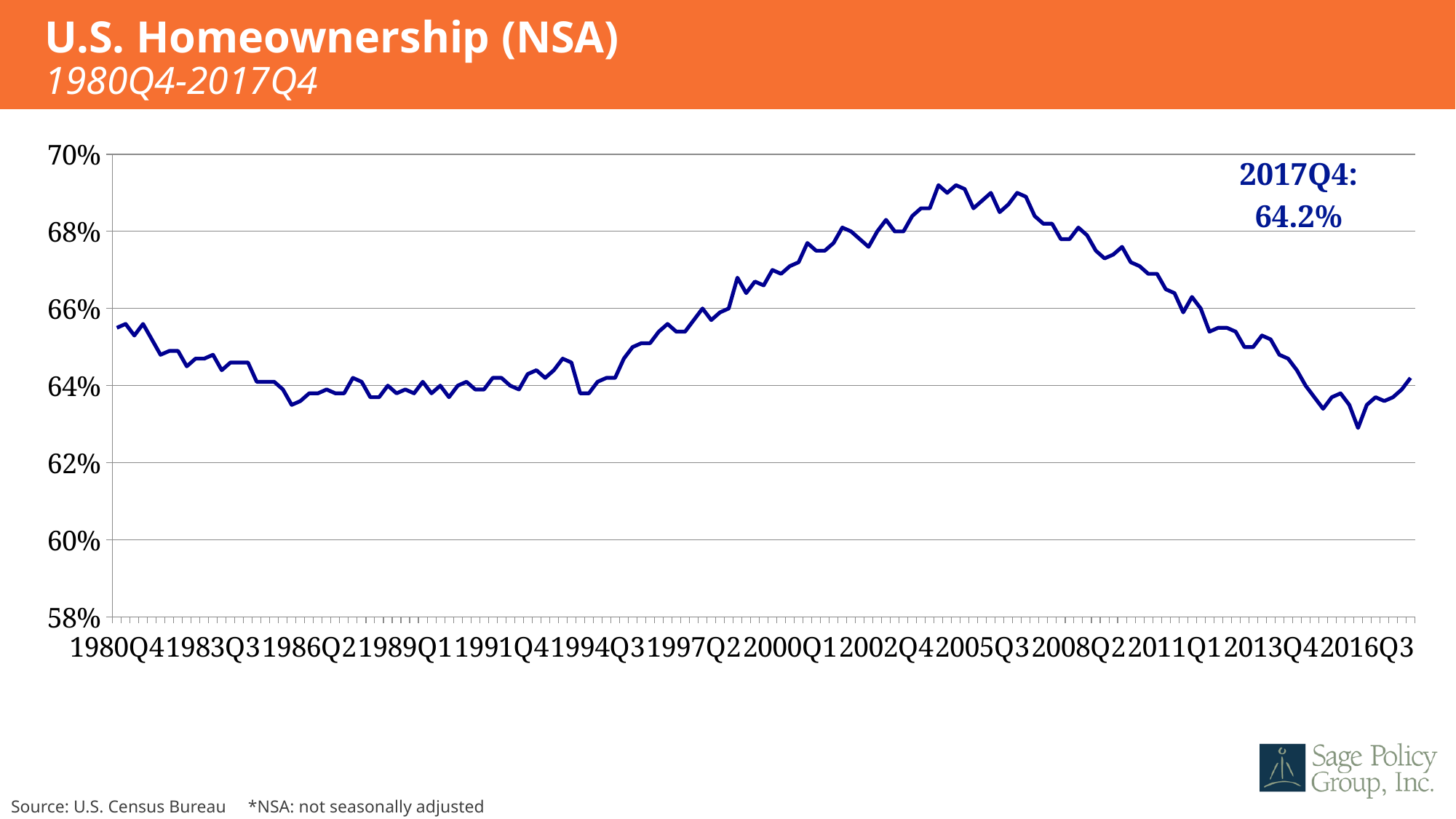
Does the homeownership rate rise or fall between 1994Q3 and 2005Q3? rise Is the lowest point on the line, around 2016, greater or less than 64%? less Does the homeownership rate rise or fall between 2005Q3 and 2016Q3? fall What is the title of the chart? U.S. Homeownership (NSA) Is the homeownership rate at 1986Q2 greater or less than 64%? less Is the peak homeownership rate around 2005Q3 greater or less than 68%? greater What type of chart is shown on the slide? line chart What period does the chart cover according to the subtitle? 1980Q4-2017Q4 What is the U.S. homeownership rate in 2017Q4 according to the label on the chart? 64.2% Which is higher, the homeownership rate around 2005Q3 or the rate around 1989Q1? 2005Q3